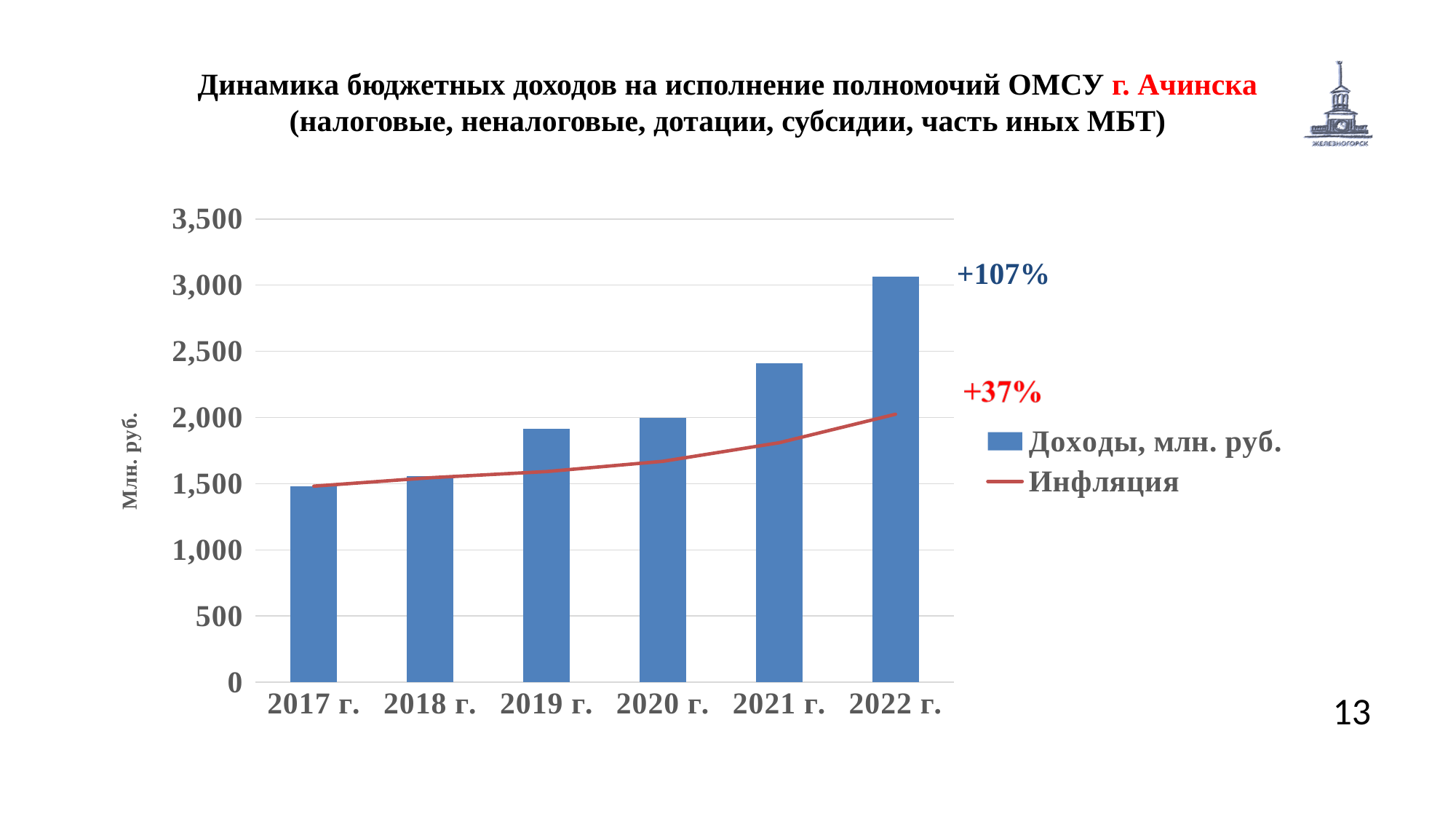
Do the values for Доходы, млн. руб. rise or fall from 2017 г. to 2022 г.? Rise Which year has the lowest value for Доходы, млн. руб.? 2017 г. Is the value for Доходы, млн. руб. in 2021 г. greater or less than 2,500? less Is the value for Доходы, млн. руб. in 2019 г. greater or less than 1,500? greater Is the value for Доходы, млн. руб. in 2022 г. greater or less than 3,000? greater How many series does the chart legend list? 2 Which year has the larger value for Доходы, млн. руб.: 2019 г. or 2018 г.? 2019 г. What percentage growth is annotated next to the Доходы bars on the chart? +107% What percentage growth is annotated for the Инфляция line on the chart? +37% Which year has the highest value for Доходы, млн. руб.? 2022 г. How many years are shown on the x axis of the chart? 6 What kind of chart is shown on the slide? Bar chart with a line